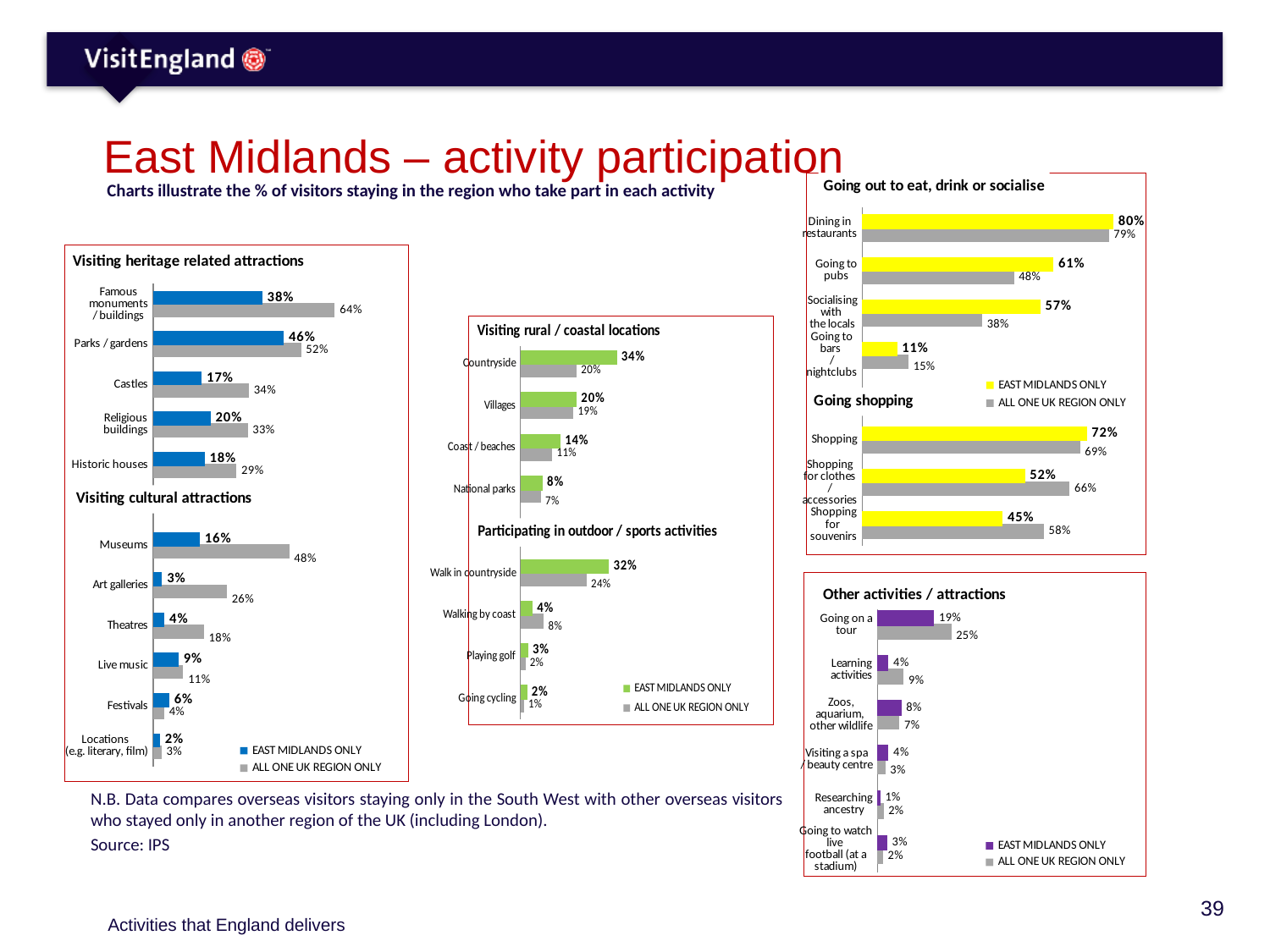
In the 'Visiting rural / coastal locations' chart, how many categories are shown? 4 In the 'Going out to eat, drink or socialise' chart, which is larger for Going to bars / nightclubs: East Midlands only or all one UK region only? All one UK region only In the 'Going shopping' chart, what is the all one UK region only value for Shopping for souvenirs? 58% In the 'Participating in outdoor / sports activities' chart, what is the East Midlands only value for Walk in countryside? 32% In the 'Visiting cultural attractions' chart, which category has the highest East Midlands only value? Museums In the 'Visiting heritage related attractions' chart, what is the value for Parks / gardens for East Midlands only? 46% In the 'Going out to eat, drink or socialise' chart, what is the difference between East Midlands only and all one UK region only for Socialising with the locals? 19% In the 'Other activities / attractions' chart, what is the East Midlands only value for Going on a tour? 19% In the 'Visiting heritage related attractions' chart, what is the value for Castles for all one UK region only? 34% In the 'Visiting rural / coastal locations' chart, which category has the lowest East Midlands only value? National parks How many series does the legend list in the 'Other activities / attractions' chart? 2 In the 'Visiting cultural attractions' chart, what is the difference between the all one UK region only value and the East Midlands only value for Museums? 32%